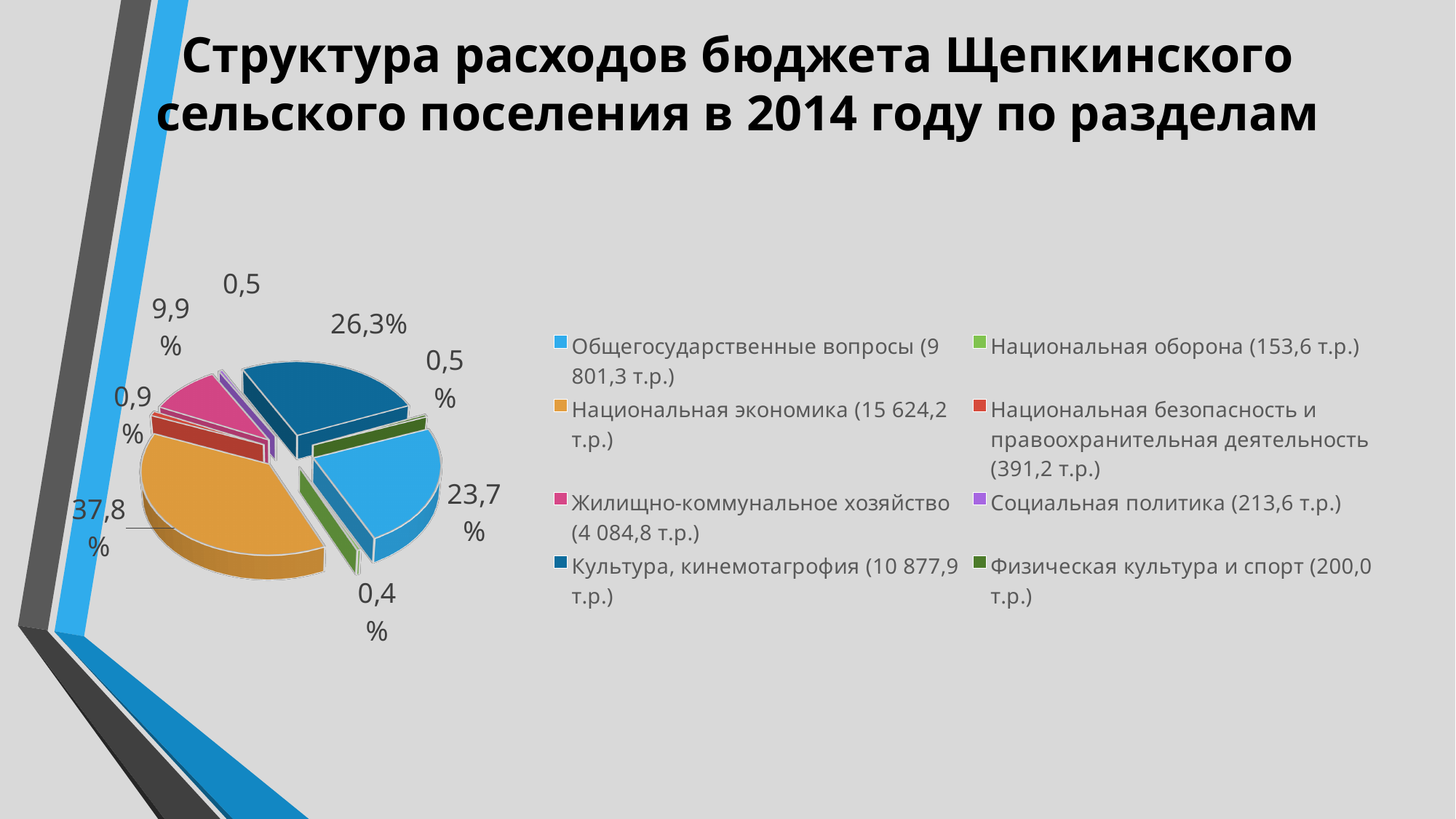
How many entries does the legend list? 8 Which has a larger share: Культура, кинемотагрофия or Общегосударственные вопросы? Культура, кинемотагрофия What share of the budget expenditure goes to Жилищно-коммунальное хозяйство? 9,9% What share of the budget expenditure goes to Культура, кинемотагрофия? 26,3% What kind of chart is shown on the slide? pie chart Which section has the largest share of the budget expenditure? Национальная экономика What share of the budget expenditure goes to Общегосударственные вопросы? 23,7% What share of the budget expenditure goes to Национальная экономика? 37,8% By how many percentage points does the share of Национальная экономика exceed the share of Общегосударственные вопросы? 14,1 Which section has the smallest share of the budget expenditure? Национальная оборона How many slices does the pie chart have? 8 According to the legend, what amount is allocated to Жилищно-коммунальное хозяйство? 4 084,8 т.р.